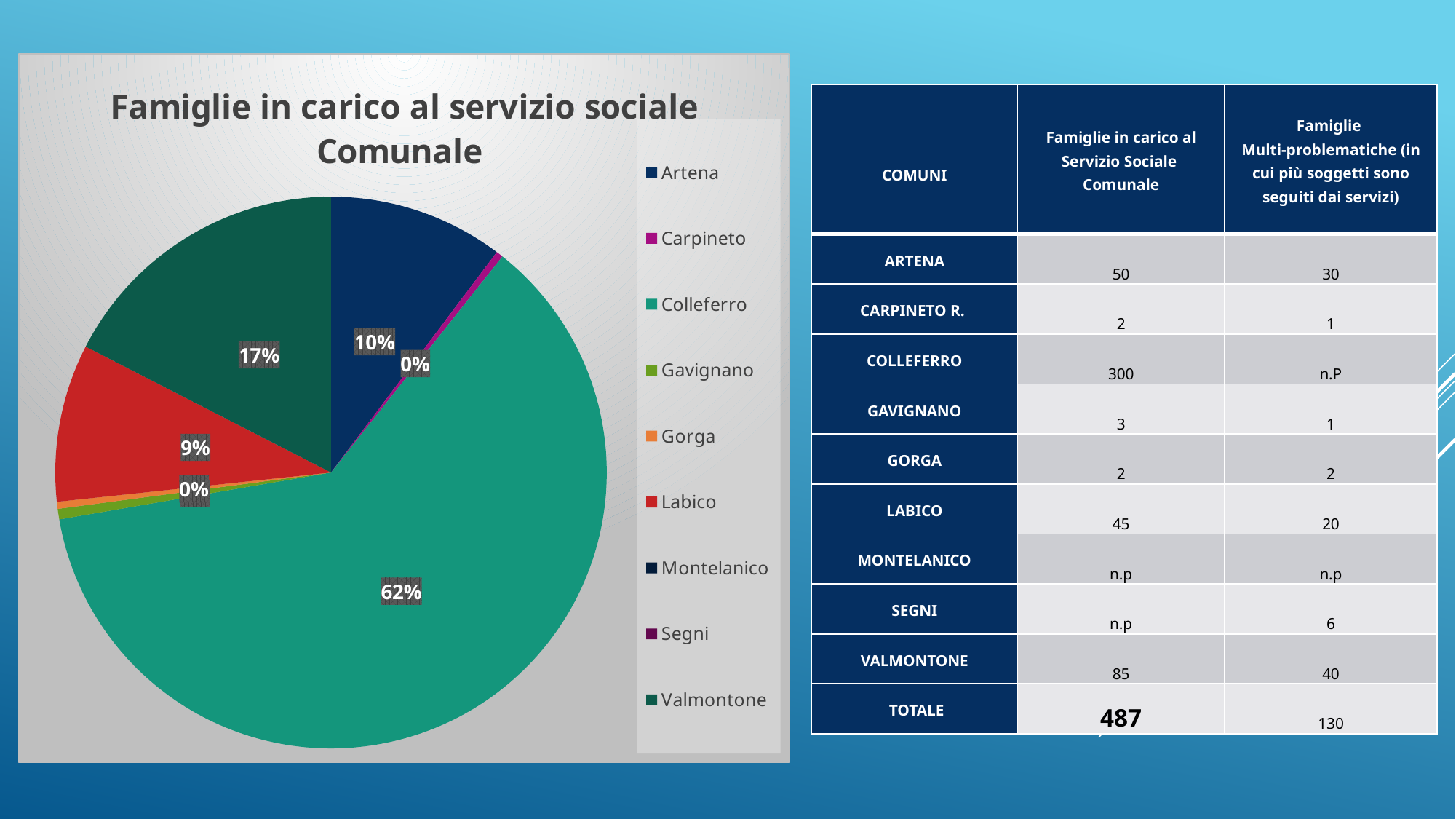
Which comune is listed last in the pie chart legend? Valmontone What kind of chart is shown on the slide? pie chart What share of the pie does Colleferro account for? 62% What is the title of the pie chart? Famiglie in carico al servizio sociale Comunale Which slice is larger, Artena or Labico? Artena What percentage is shown for Labico in the pie chart? 9% What percentage is shown for Valmontone in the pie chart? 17% Which comune has the largest slice of the pie? Colleferro How many comuni are listed in the pie chart legend? 9 What percentage is shown for Artena in the pie chart? 10% Which slice is larger, Valmontone or Artena? Valmontone By how many percentage points does Colleferro's share exceed Valmontone's share? 45 percentage points